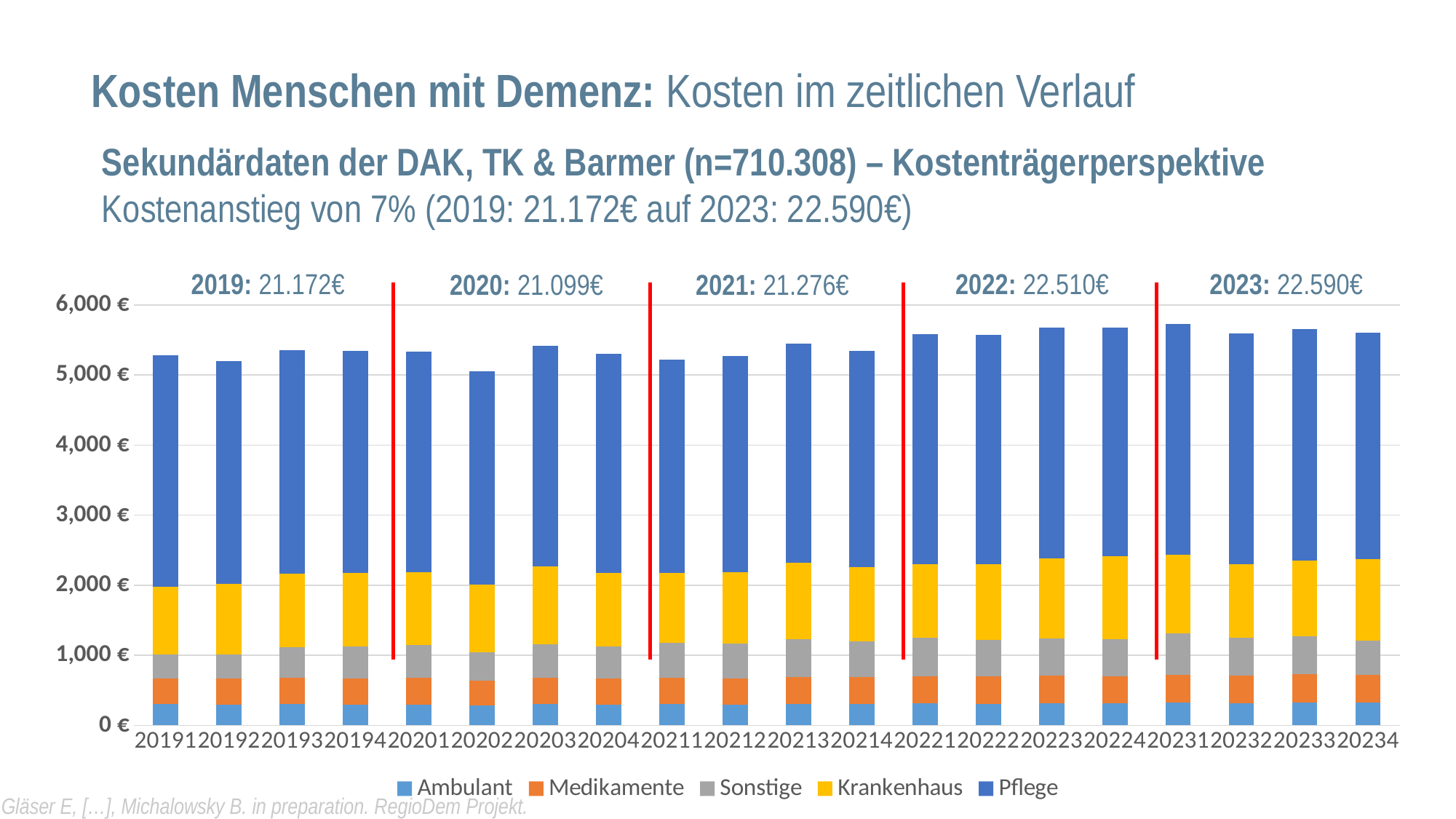
Do the annual costs printed above the chart rise or fall from 2021 to 2023? rise What annual cost is printed above the chart for 2023? 22.590€ What kind of chart is shown on the slide? stacked bar chart How many quarterly bars are plotted in the chart? 20 What annual cost is printed above the chart for 2019? 21.172€ Which year has the lowest annual cost printed above the chart? 2020 Is the total height of the bar for 20231 greater or less than 5,000 €? greater How many series does the legend list? 5 Which year has the highest annual cost printed above the chart? 2023 Which series forms the top segment of each stacked bar? Pflege What is the difference between the annual cost printed for 2023 and for 2019? 1.418€ Which annual cost printed above the chart is larger, 2021 or 2022? 2022